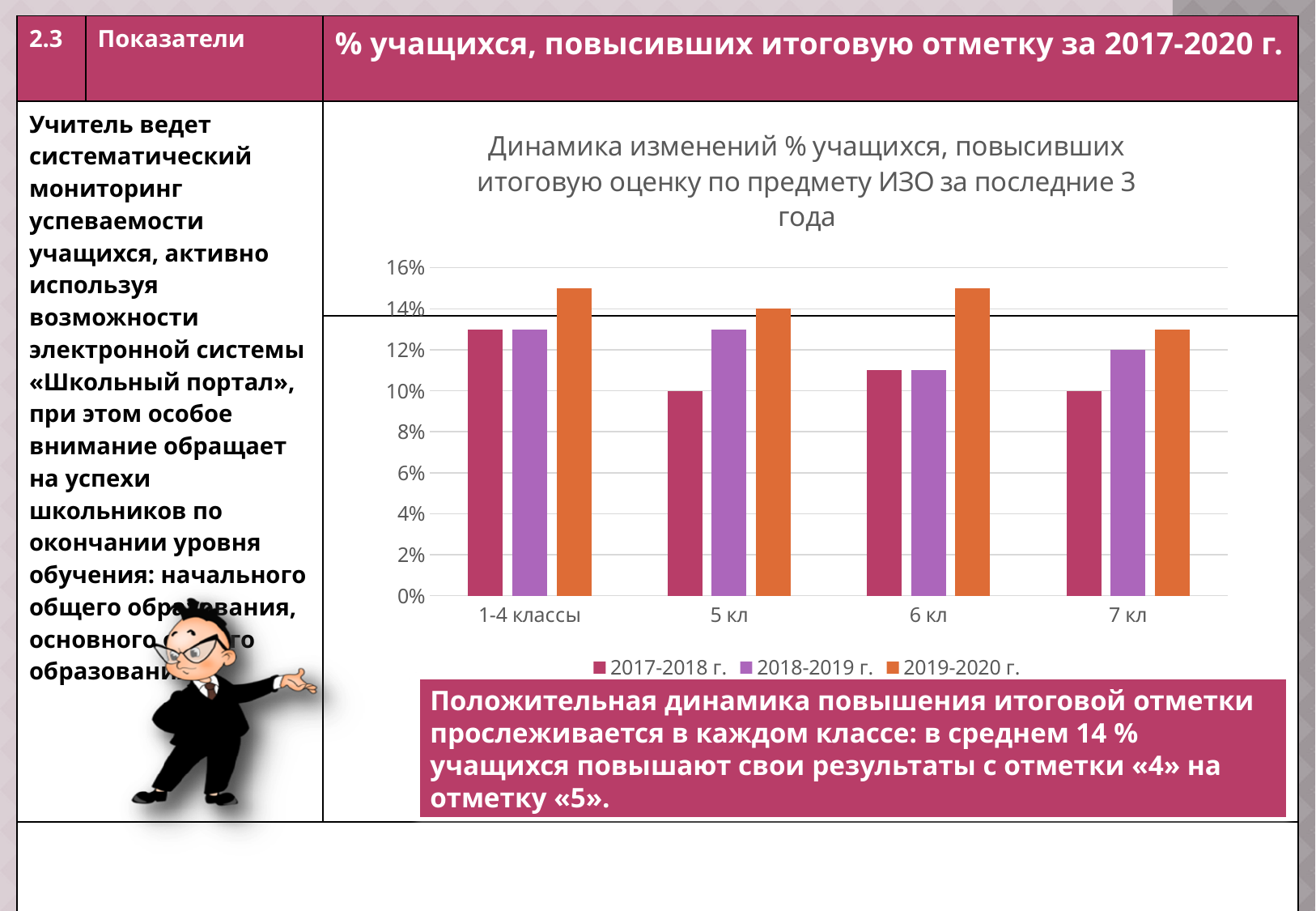
What is the title of the chart? Динамика изменений % учащихся, повысивших итоговую оценку по предмету ИЗО за последние 3 года What is the value for 7 кл in 2018-2019 г.? 12% How many class categories are shown on the x axis of the chart? 4 For 5 кл, which series has the highest value? 2019-2020 г. What is the value for 5 кл in 2017-2018 г.? 10% Is the value for 1-4 классы in 2019-2020 г. greater or less than 14%? greater What kind of chart is shown on the slide? bar chart In the 2019-2020 г. series, which is larger: the value for 6 кл or for 7 кл? 6 кл For 1-4 классы, which is larger: the value for 2017-2018 г. or for 2019-2020 г.? 2019-2020 г. Is the value for 6 кл in 2017-2018 г. greater or less than 12%? less How many series does the chart legend list? 3 For 7 кл, which series has the lowest value? 2017-2018 г.